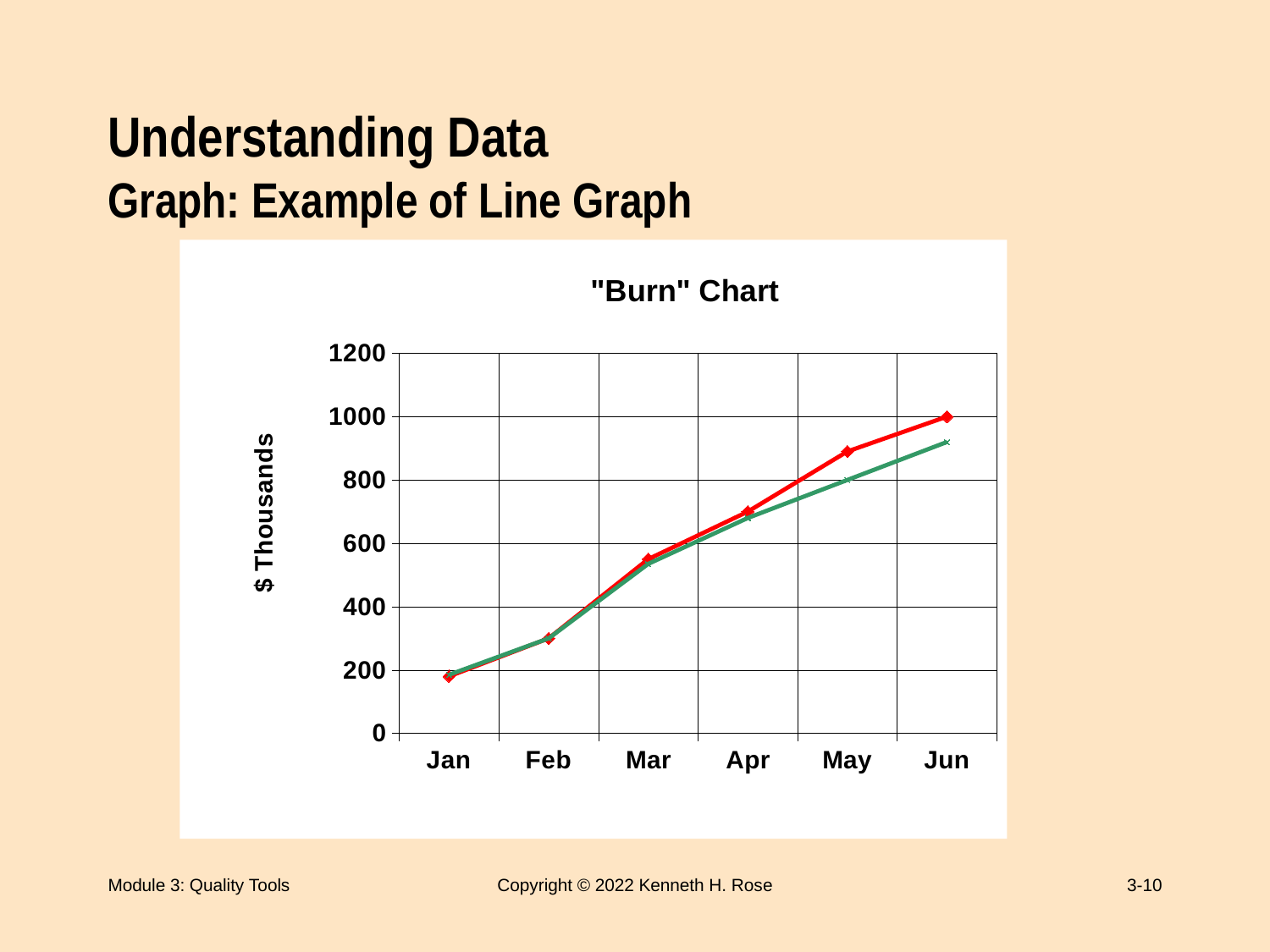
How many months are shown on the x axis of the "Burn" Chart? 6 In Jun, which line is higher, the red line or the green line? Red line In which month does the red line have its lowest value? Jan Is the value of the red line in Jan greater or less than 200? less How many lines are plotted on the "Burn" Chart? 2 What is the value of the red line in Jun on the "Burn" Chart? 1000 What kind of chart is the "Burn" Chart? Line chart In which month does the red line reach its highest value? Jun Is the value of the red line in May greater or less than 800? greater Do the values on the "Burn" Chart rise or fall from Jan to Jun? Rise Is the value of the green line in Jun greater or less than 1000? less